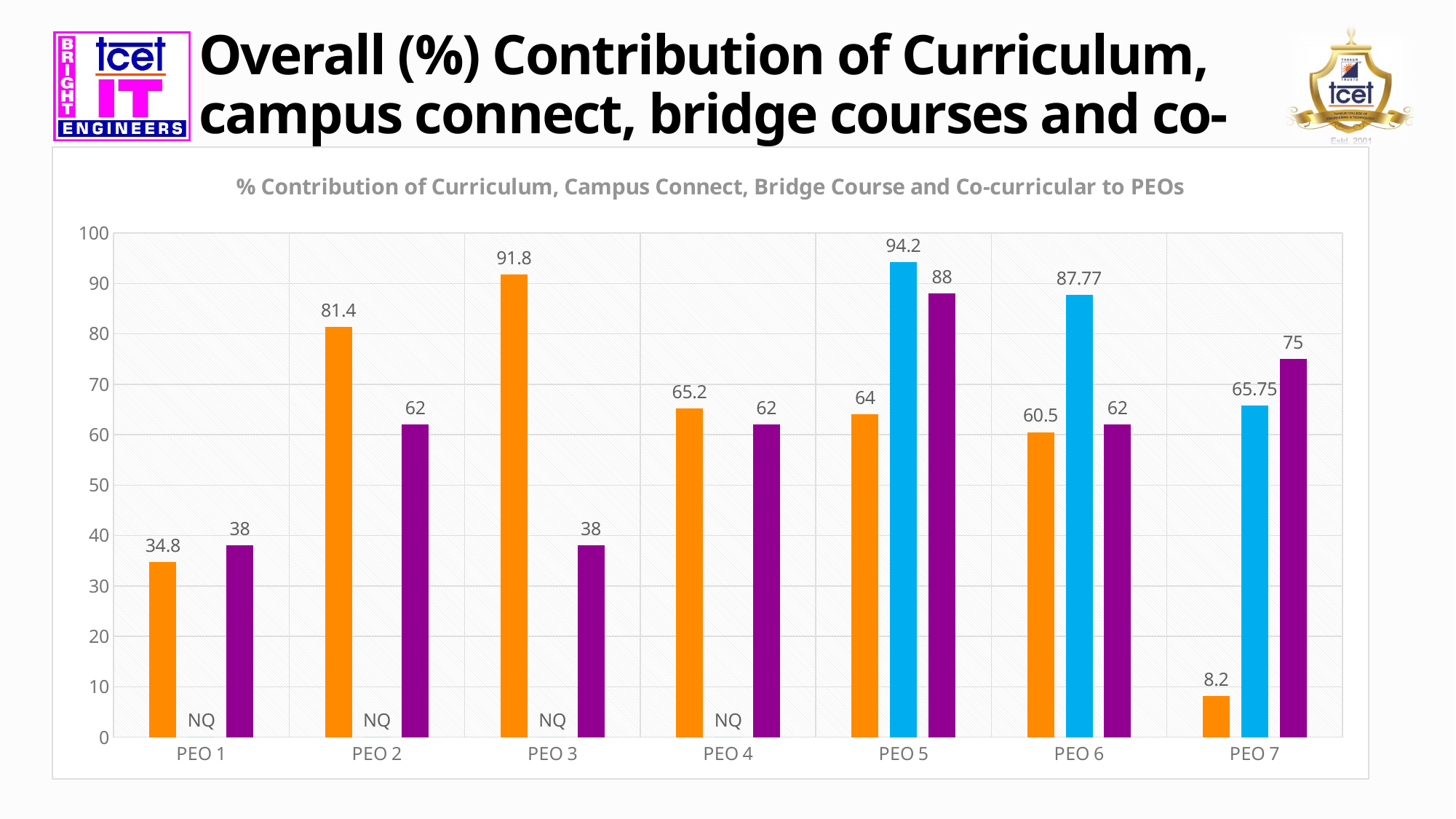
What is the difference between the blue bar and the purple bar for PEO 5? 6.2 What is the value of the orange bar for PEO 3? 91.8 What is the value of the blue bar for PEO 5? 94.2 Which PEO has the lowest orange bar? PEO 7 What is the difference between the orange bar for PEO 2 and the orange bar for PEO 1? 46.6 What label is shown in place of the blue bar for PEO 1 through PEO 4? NQ How many PEO categories are shown on the x axis? 7 Which PEO has the highest purple bar? PEO 5 For PEO 6, which is larger: the orange bar or the purple bar? purple bar What is the value of the purple bar for PEO 7? 75 Which PEO has the highest orange bar? PEO 3 What kind of chart is shown on the slide? bar chart